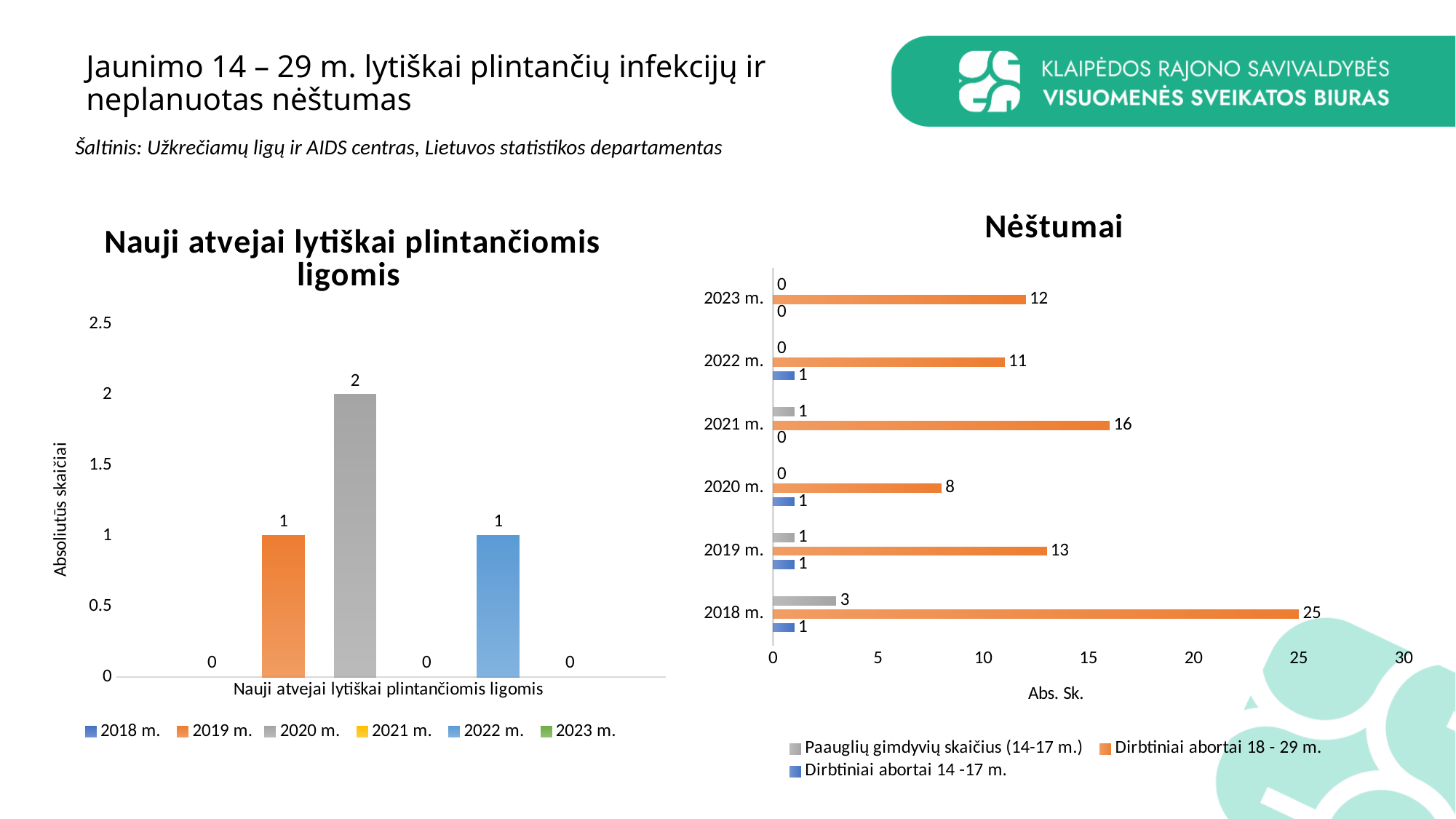
In the 'Nėštumai' chart, which year has the lowest value for 'Dirbtiniai abortai 18 - 29 m.'? 2020 m. In the 'Nėštumai' chart, what is the value of 'Dirbtiniai abortai 18 - 29 m.' for 2021 m.? 16 In the 'Nauji atvejai lytiškai plintančiomis ligomis' chart, what is the value for 2020 m.? 2 In the 'Nėštumai' chart, is 'Dirbtiniai abortai 18 - 29 m.' larger in 2022 m. or in 2019 m.? 2019 m. What kind of chart is 'Nauji atvejai lytiškai plintančiomis ligomis'? Bar chart How many series does the legend of the 'Nauji atvejai lytiškai plintančiomis ligomis' chart list? 6 In the 'Nėštumai' chart, what is the value of 'Paauglių gimdyvių skaičius (14-17 m.)' for 2018 m.? 3 In the 'Nėštumai' chart, which year has the highest value for 'Dirbtiniai abortai 18 - 29 m.'? 2018 m. How many year categories are shown in the 'Nėštumai' chart? 6 In the 'Nauji atvejai lytiškai plintančiomis ligomis' chart, which year has the highest value? 2020 m. In the 'Nėštumai' chart, what is the difference between 'Dirbtiniai abortai 18 - 29 m.' in 2018 m. and 2023 m.? 13 What is the x-axis label of the 'Nėštumai' chart? Abs. Sk.